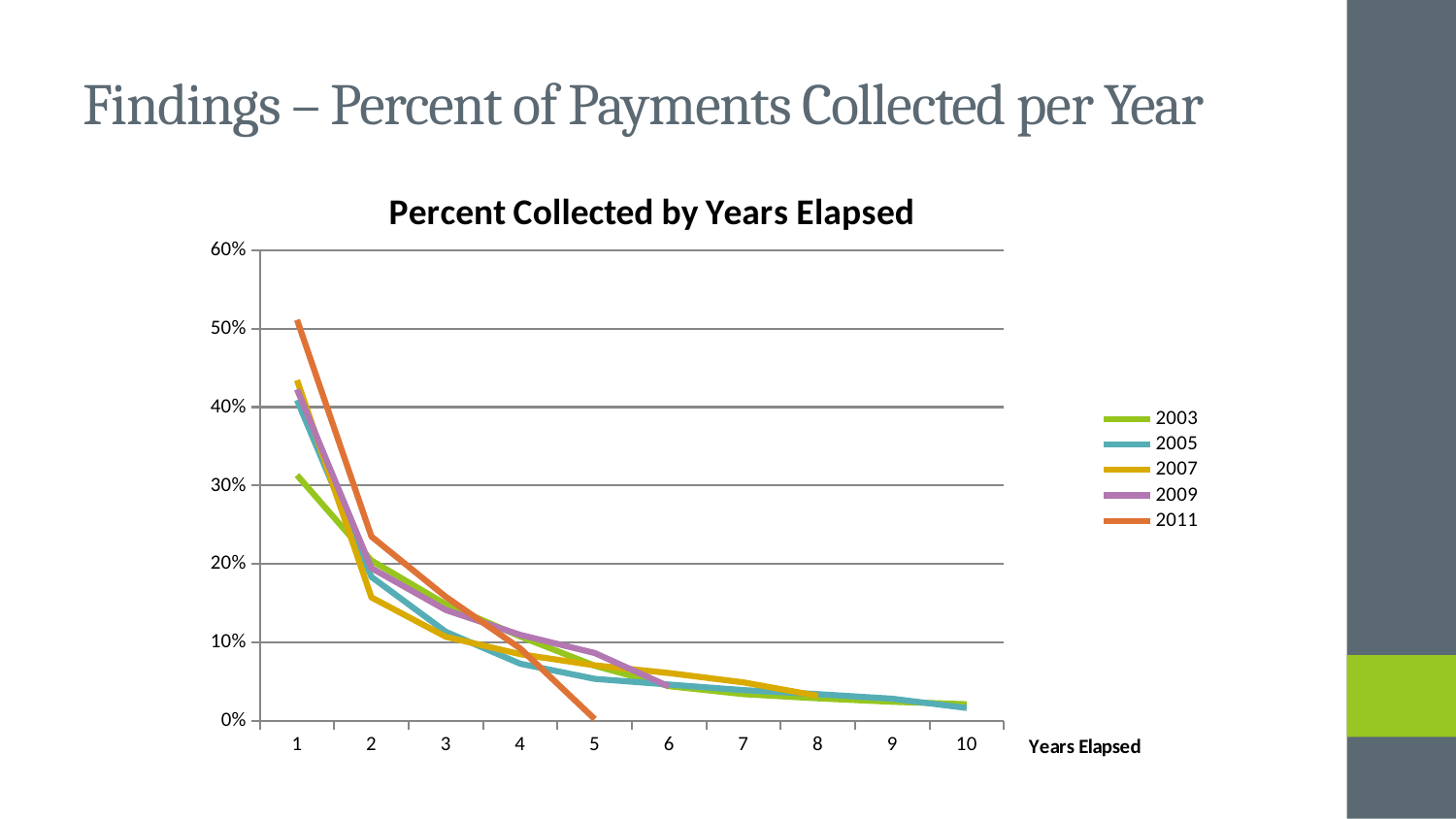
What is the label on the x axis of the chart? Years Elapsed How many series does the legend list? 5 Is the value for 2011 at year 1 greater or less than 40%? greater Is the value for 2003 at year 1 greater or less than 40%? less What kind of chart is shown on the slide? Line chart Which series has the lowest percent collected at year 1? 2003 What is the title of the chart? Percent Collected by Years Elapsed How many years-elapsed points are shown along the x axis? 10 At year 2, which series has the larger value, 2007 or 2011? 2011 Which series has the highest percent collected at year 1? 2011 Do the percent collected values rise or fall as years elapsed increase? Fall Is the value for 2005 at year 10 greater or less than 10%? less